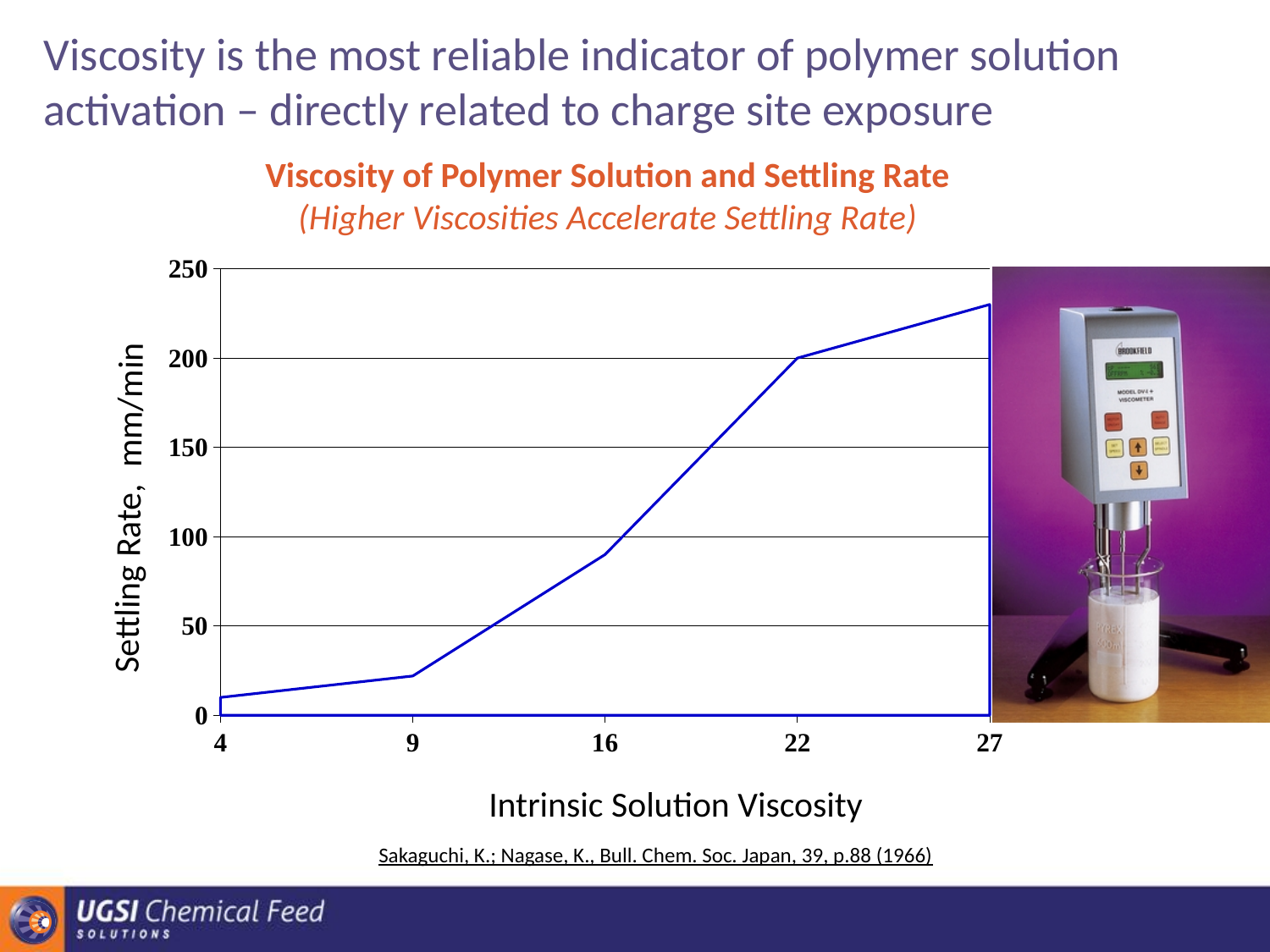
Is the settling rate at an intrinsic solution viscosity of 27 greater or less than 200? greater Is the settling rate at an intrinsic solution viscosity of 16 greater or less than 100? less What kind of chart is shown on the slide? line chart Is the settling rate at an intrinsic solution viscosity of 9 greater or less than 50? less How many data points are plotted on the line? 5 Do the settling rate values rise or fall as intrinsic solution viscosity increases along the x axis? rise What is the title of the chart? Viscosity of Polymer Solution and Settling Rate What is the label of the y axis? Settling Rate, mm/min Which has the larger settling rate: an intrinsic solution viscosity of 22 or of 9? 22 At which intrinsic solution viscosity is the settling rate lowest? 4 At which intrinsic solution viscosity is the settling rate highest? 27